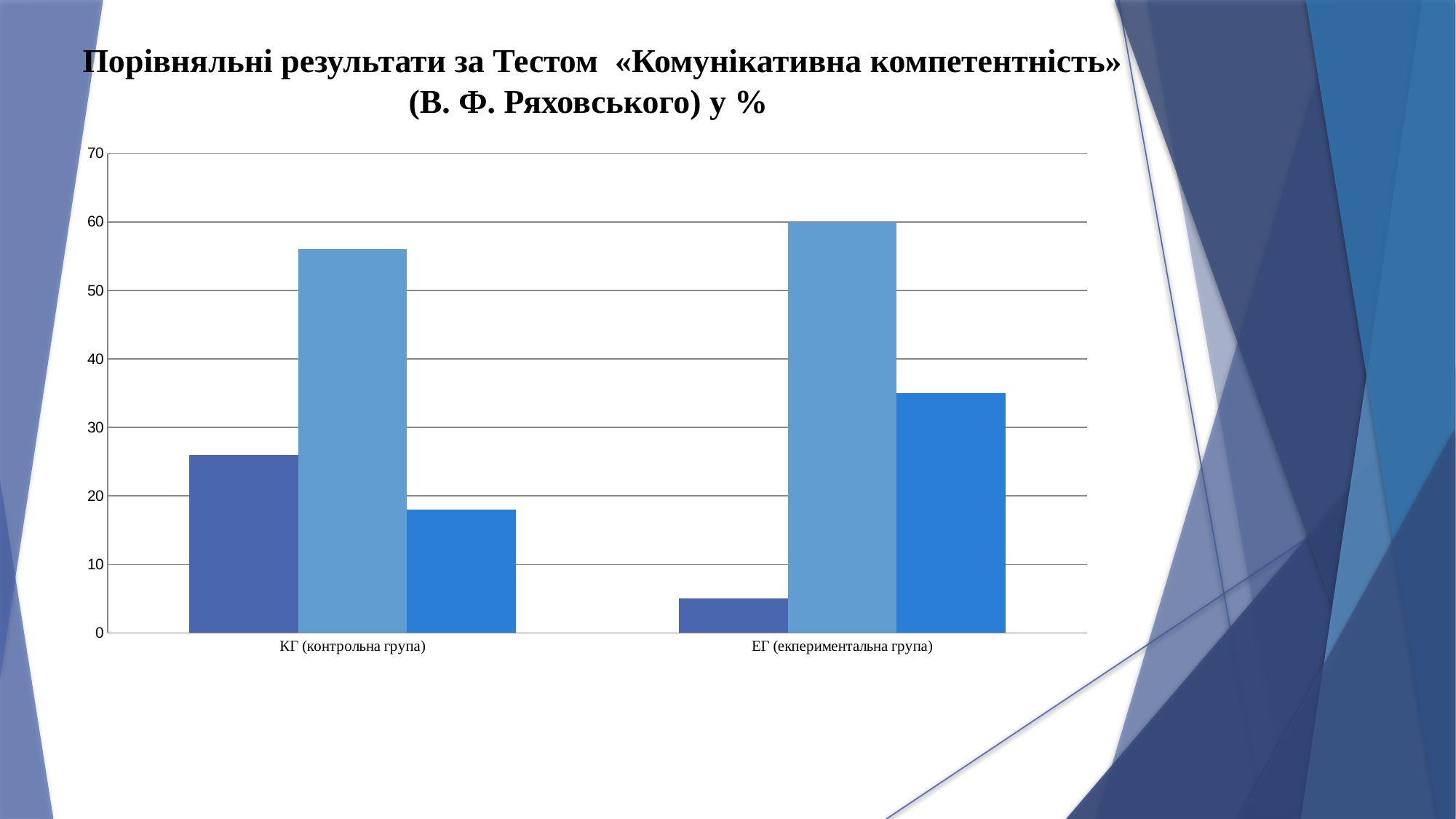
Is the value of the first (left) bar for КГ (контрольна група) greater or less than 20? greater Is the value of the third (right) bar for ЕГ (екпериментальна група) greater or less than 30? greater Which category has the taller middle (light blue) bar, КГ (контрольна група) or ЕГ (екпериментальна група)? ЕГ (екпериментальна група) What kind of chart is shown on the slide? bar chart What is the value of the middle (light blue) bar for ЕГ (екпериментальна група)? 60 How many categories are shown on the x axis? 2 Is the value of the first (left) bar for ЕГ (екпериментальна група) greater or less than 10? less Which category contains the tallest bar in the chart? ЕГ (екпериментальна група) Which category has the taller first (left) bar, КГ (контрольна група) or ЕГ (екпериментальна група)? КГ (контрольна група) How many bars are plotted for each category? 3